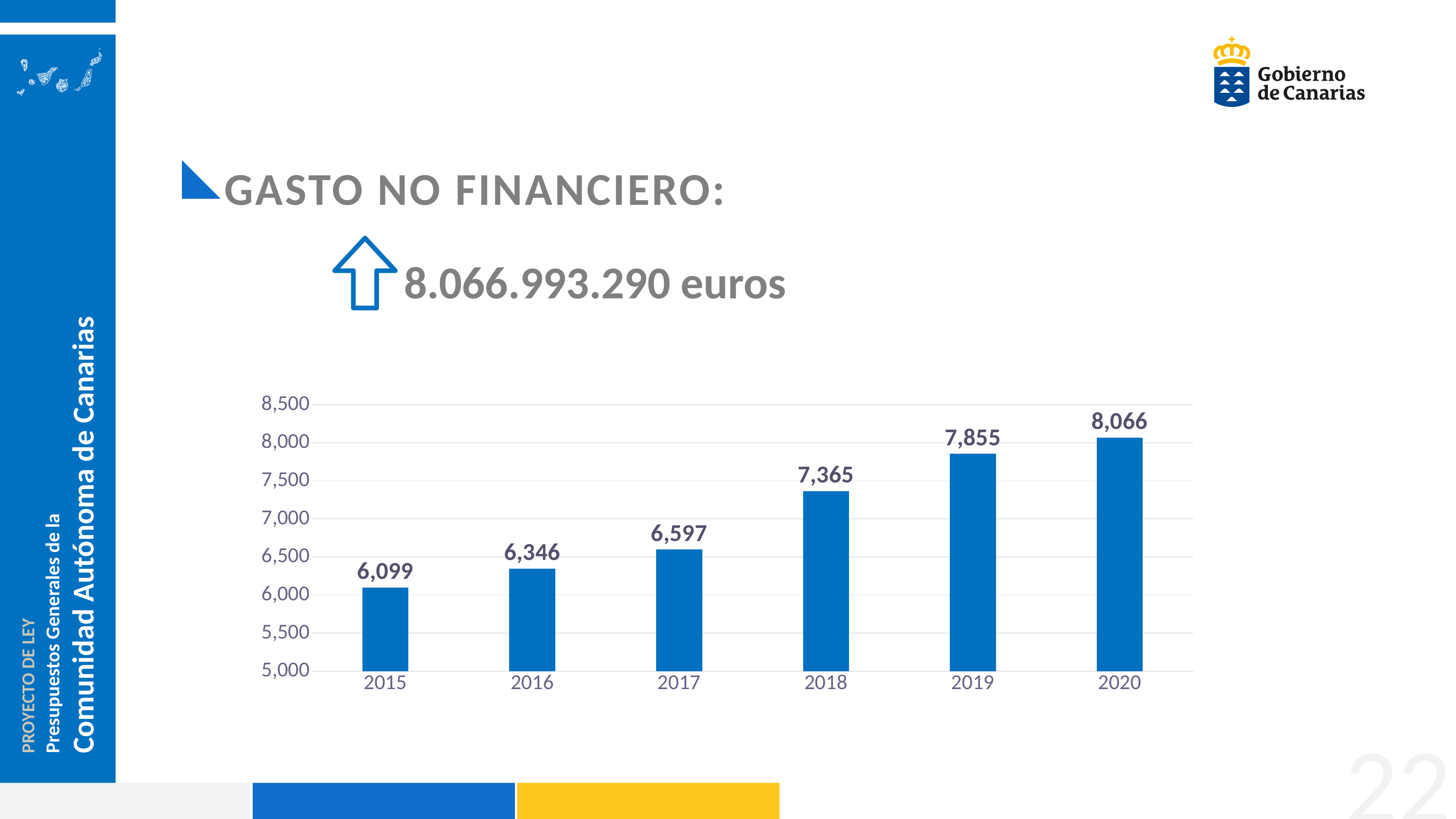
Do the values rise or fall from 2015 to 2020? rise What is the value for 2015? 6,099 Is the value for 2019 greater or less than 7,500? greater Which is larger, the value for 2018 or the value for 2017? 2018 What is the value for 2018? 7,365 What is the value for 2020? 8,066 What is the difference between the values for 2020 and 2019? 211 What is the difference between the values for 2017 and 2016? 251 How many years are shown on the x axis? 6 Which year has the lowest value? 2015 What kind of chart is shown on the slide? bar chart Which year has the highest value? 2020